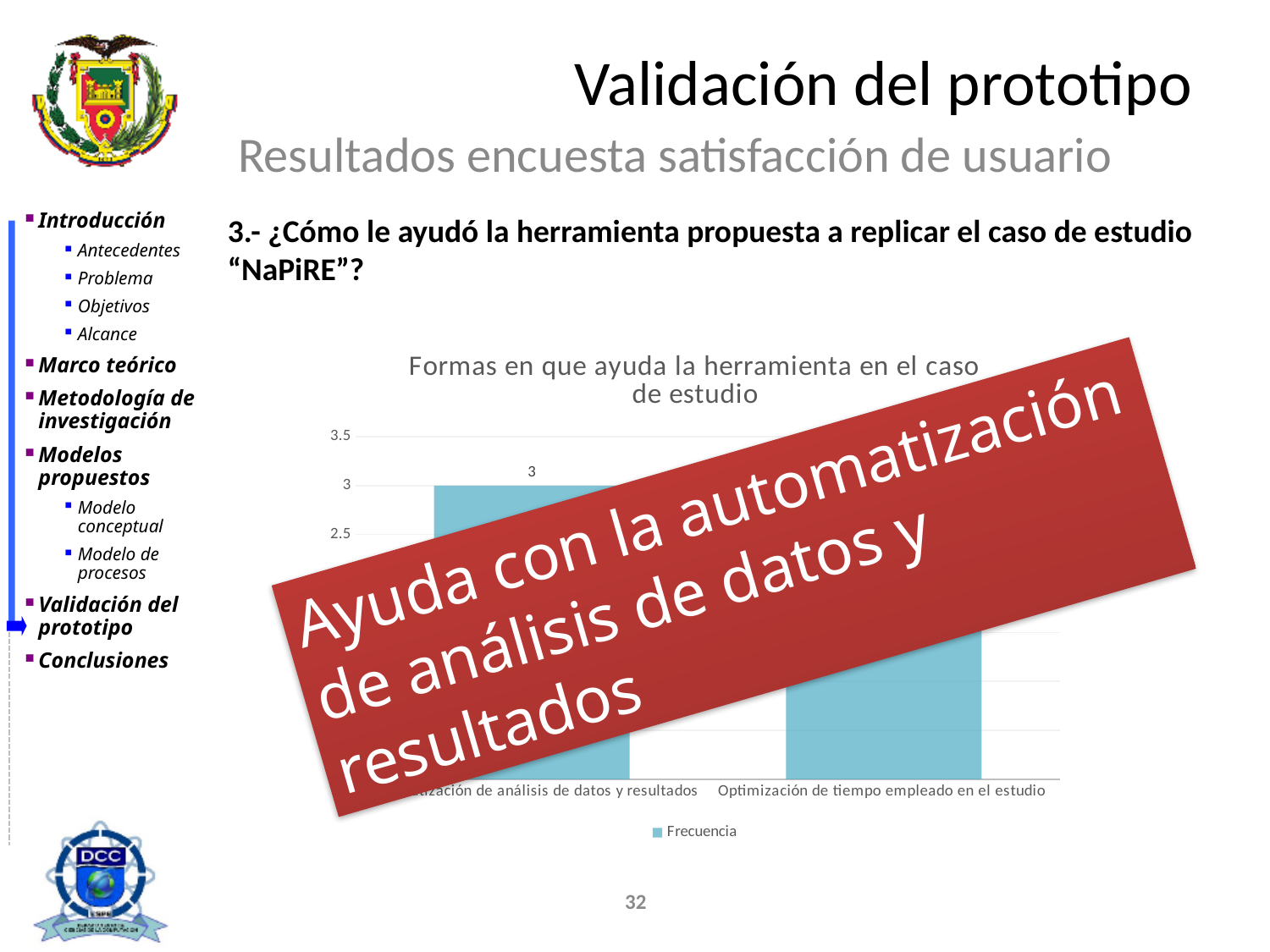
What is the name of the series shown in the chart legend? Frecuencia What is the value of the bar for the category ending in "análisis de datos y resultados"? 3 What is the title of the chart? Formas en que ayuda la herramienta en el caso de estudio What is the label of the rightmost category on the x axis? Optimización de tiempo empleado en el estudio Is the value for the category ending in "análisis de datos y resultados" greater or less than 2.5? greater How many series does the chart legend list? 1 Is the value for the category ending in "análisis de datos y resultados" greater or less than 3.5? less What type of chart is shown on the slide? bar chart How many categories are shown on the x axis of the chart? 2